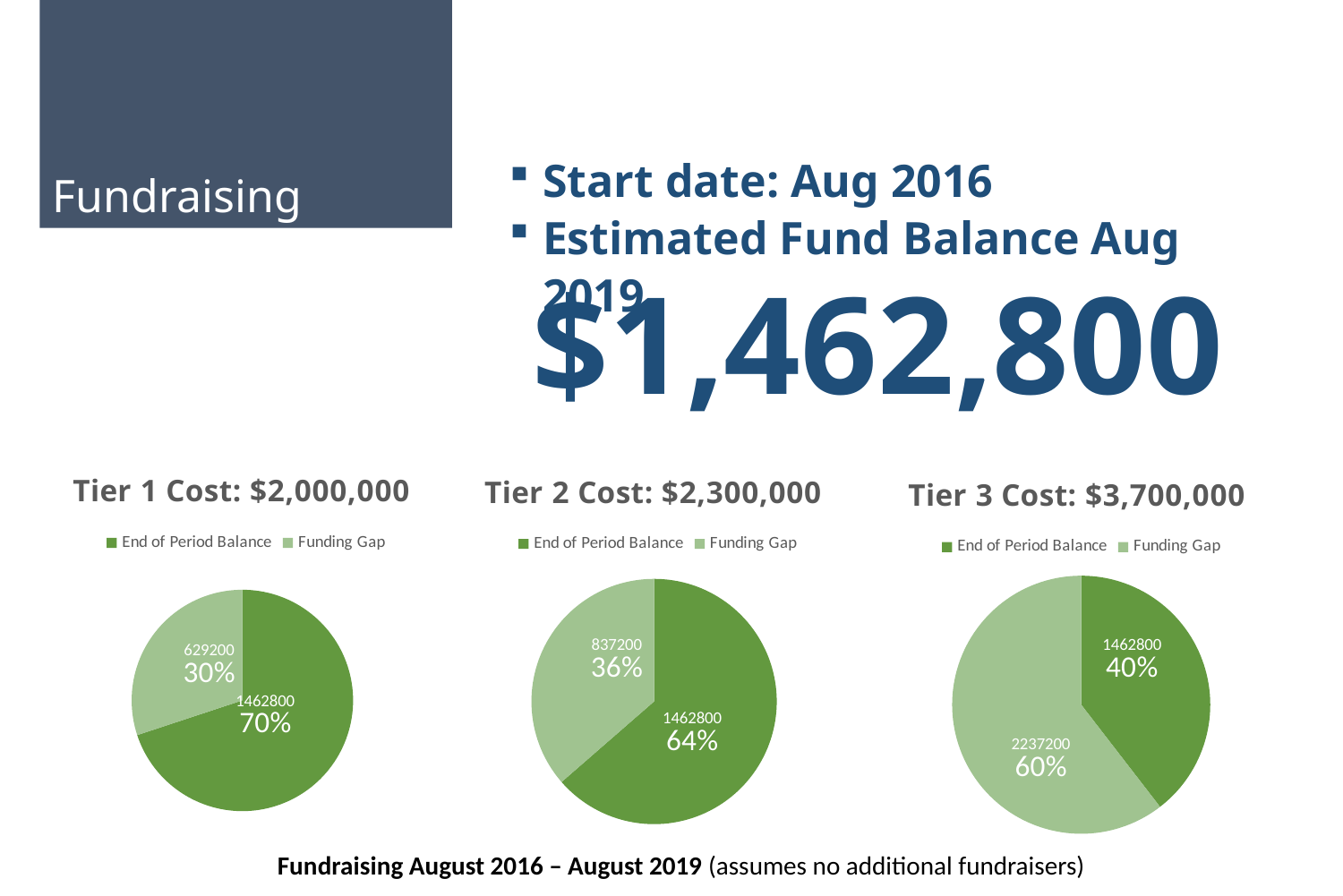
In the Tier 2 Cost: $2,300,000 chart, what is the difference between the End of Period Balance and the Funding Gap values? 625600 How many pie charts are shown on the slide? 3 In the Tier 1 Cost: $2,000,000 chart, which slice is the largest? End of Period Balance What type of chart is used for the Tier 1 Cost: $2,000,000 chart? Pie chart In the Tier 3 Cost: $3,700,000 chart, which slice is larger, End of Period Balance or Funding Gap? Funding Gap In the Tier 3 Cost: $3,700,000 chart, what is the value of the Funding Gap slice? 2237200 In the Tier 1 Cost: $2,000,000 chart, what share of the pie is End of Period Balance? 70% In the Tier 2 Cost: $2,300,000 chart, what share of the pie is Funding Gap? 36% In the Tier 2 Cost: $2,300,000 chart, what is the value of the Funding Gap slice? 837200 In the Tier 3 Cost: $3,700,000 chart, what share of the pie is End of Period Balance? 40% How many entries does the legend of the Tier 2 Cost: $2,300,000 chart list? 2 In the Tier 1 Cost: $2,000,000 chart, what is the value of the Funding Gap slice? 629200